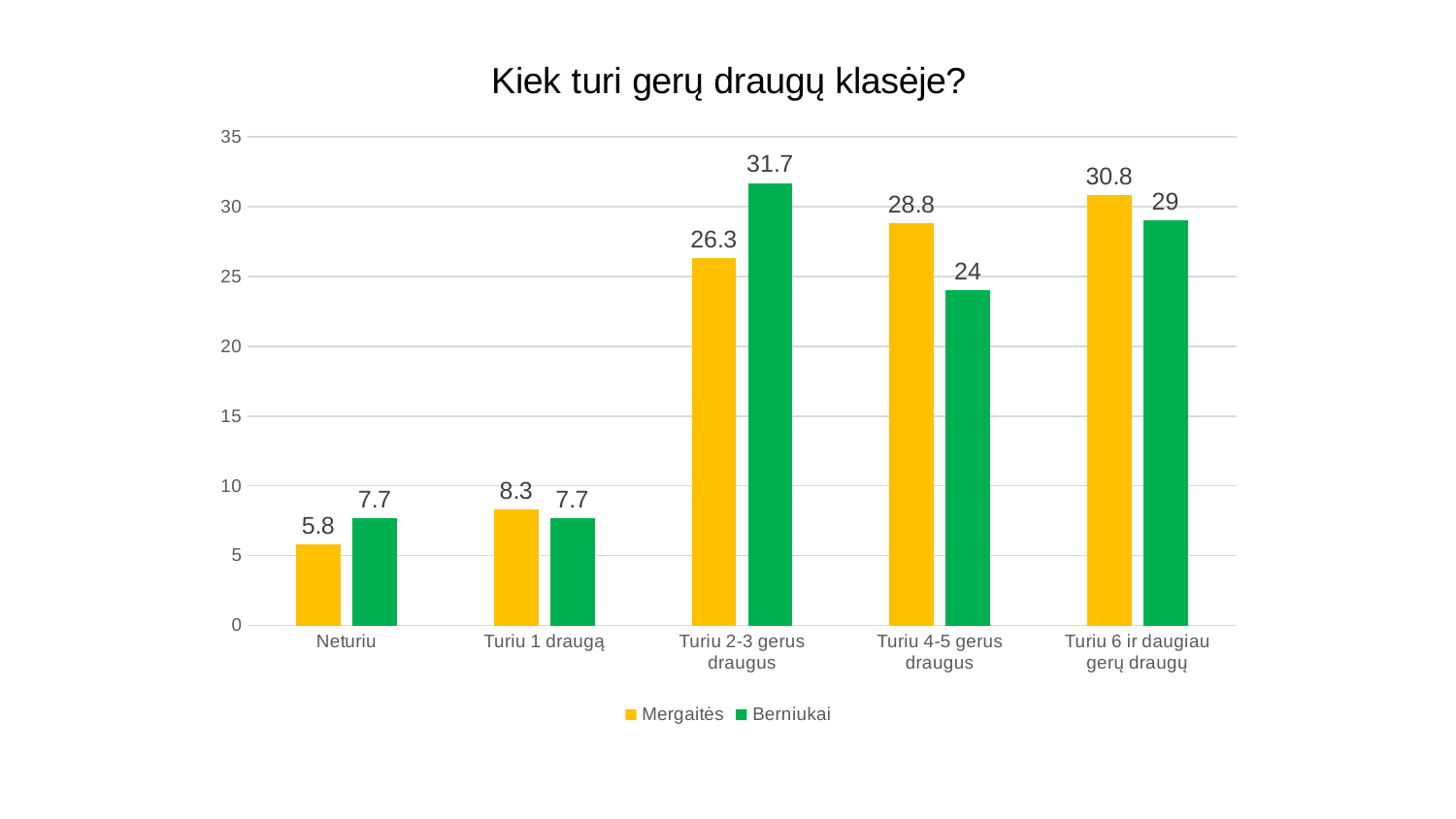
Which category has the lowest value for Mergaitės? Neturiu Which is larger in the 'Turiu 6 ir daugiau gerų draugų' category, Mergaitės or Berniukai? Mergaitės How many series does the legend list? 2 What kind of chart is shown on the slide? bar chart What is the value for Berniukai in the 'Turiu 4-5 gerus draugus' category? 24 Which category has the highest value for Berniukai? Turiu 2-3 gerus draugus How many categories are shown on the x axis? 5 Is the value for Berniukai in 'Turiu 2-3 gerus draugus' greater or less than 30? greater What is the value for Mergaitės in the 'Turiu 2-3 gerus draugus' category? 26.3 What is the value for Berniukai in the 'Neturiu' category? 7.7 What is the title of the chart? Kiek turi gerų draugų klasėje? What is the difference between Mergaitės and Berniukai in the 'Turiu 4-5 gerus draugus' category? 4.8